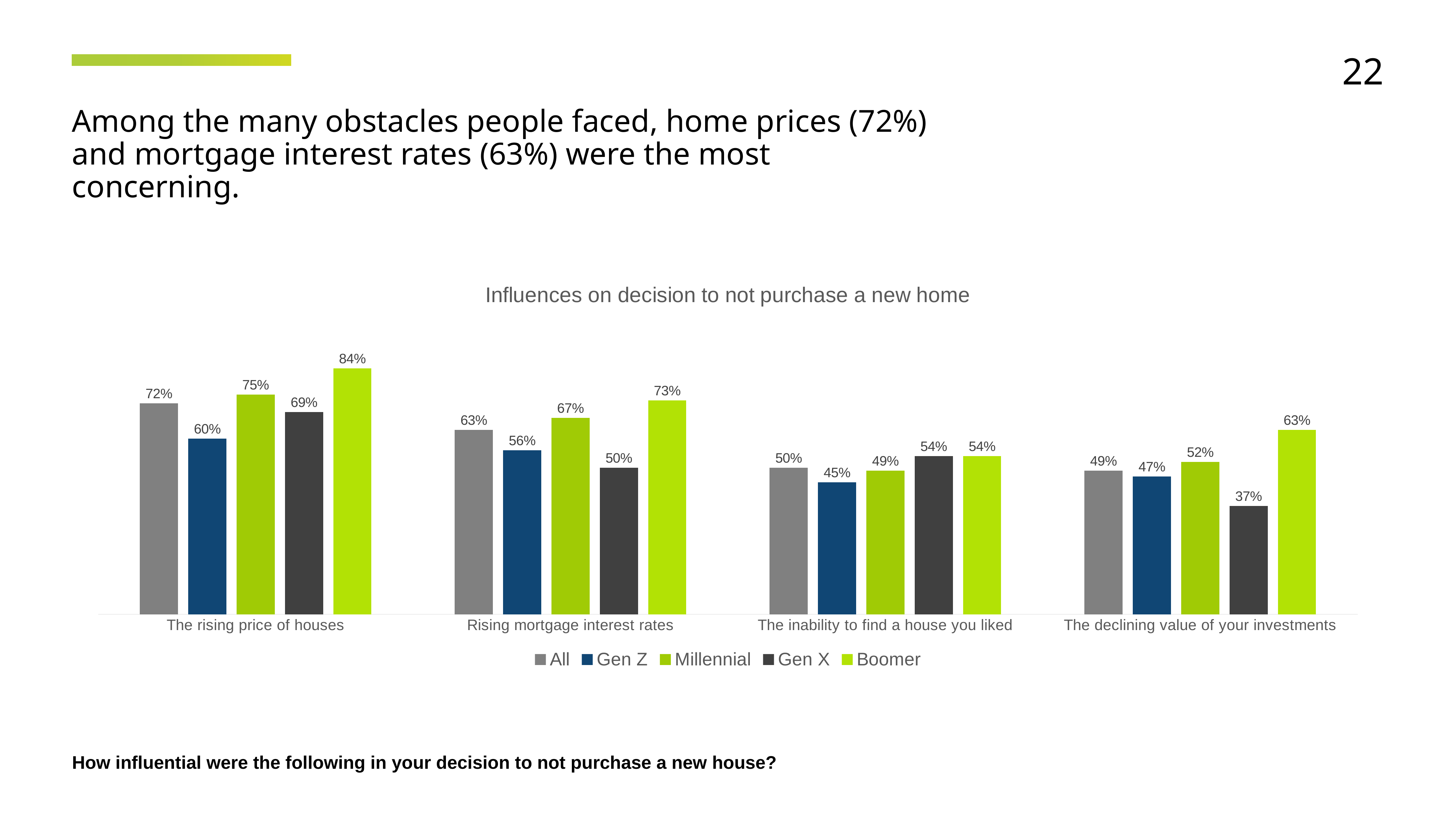
Which is larger in the category 'The inability to find a house you liked': the Millennial value or the Gen X value? Gen X Which series has the lowest value in the category 'The declining value of your investments'? Gen X What is the value for Gen Z in the category 'The declining value of your investments'? 47% Do the values for the 'All' series rise or fall across the categories from left to right? Fall What is the value for Boomer in the category 'The rising price of houses'? 84% Which series has the highest value in the category 'The rising price of houses'? Boomer What is the value for Gen X in the category 'Rising mortgage interest rates'? 50% What is the difference between the Boomer and Gen Z values in the category 'Rising mortgage interest rates'? 17% How many categories are shown on the x axis? 4 How many series does the legend list? 5 What kind of chart is shown on the slide? Bar chart What is the title of the chart? Influences on decision to not purchase a new home